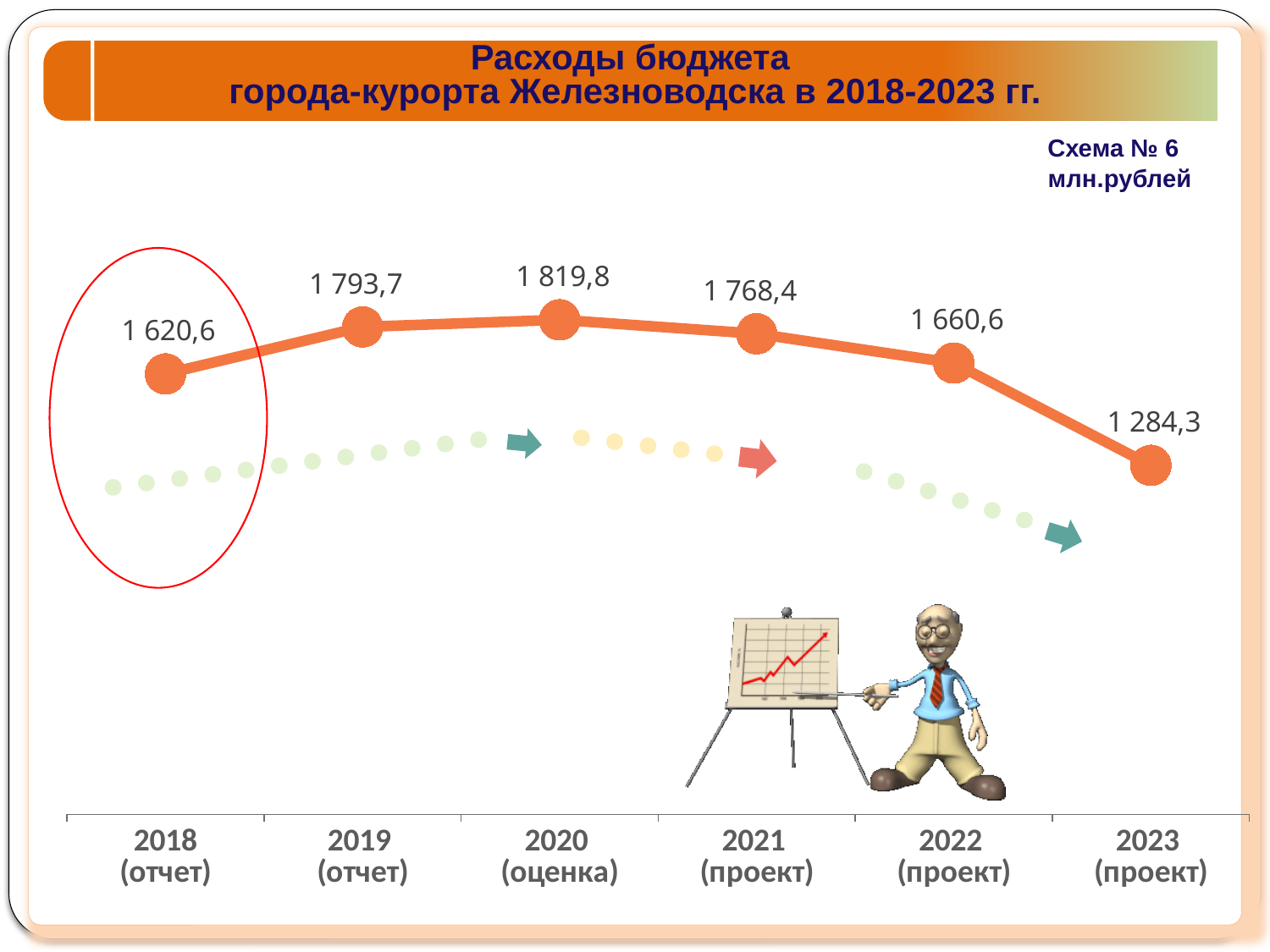
What is the budget expenditure value shown for 2018 (отчет)? 1 620,6 What is the value shown for 2023 (проект)? 1 284,3 By how much does the value for 2020 exceed the value for 2019? 26,1 How many years (data points) are plotted on the chart? 6 In what units are the values on the chart expressed, according to the slide? млн.рублей Which year has the lowest budget expenditure value? 2023 (проект) What type of chart is shown on the slide? line chart Which is larger, the value for 2019 or the value for 2021? 2019 What is the difference between the values for 2022 and 2023? 376,3 Which year has the highest budget expenditure value? 2020 (оценка) What value is shown for 2022 (проект)? 1 660,6 What value is plotted for 2020 (оценка)? 1 819,8